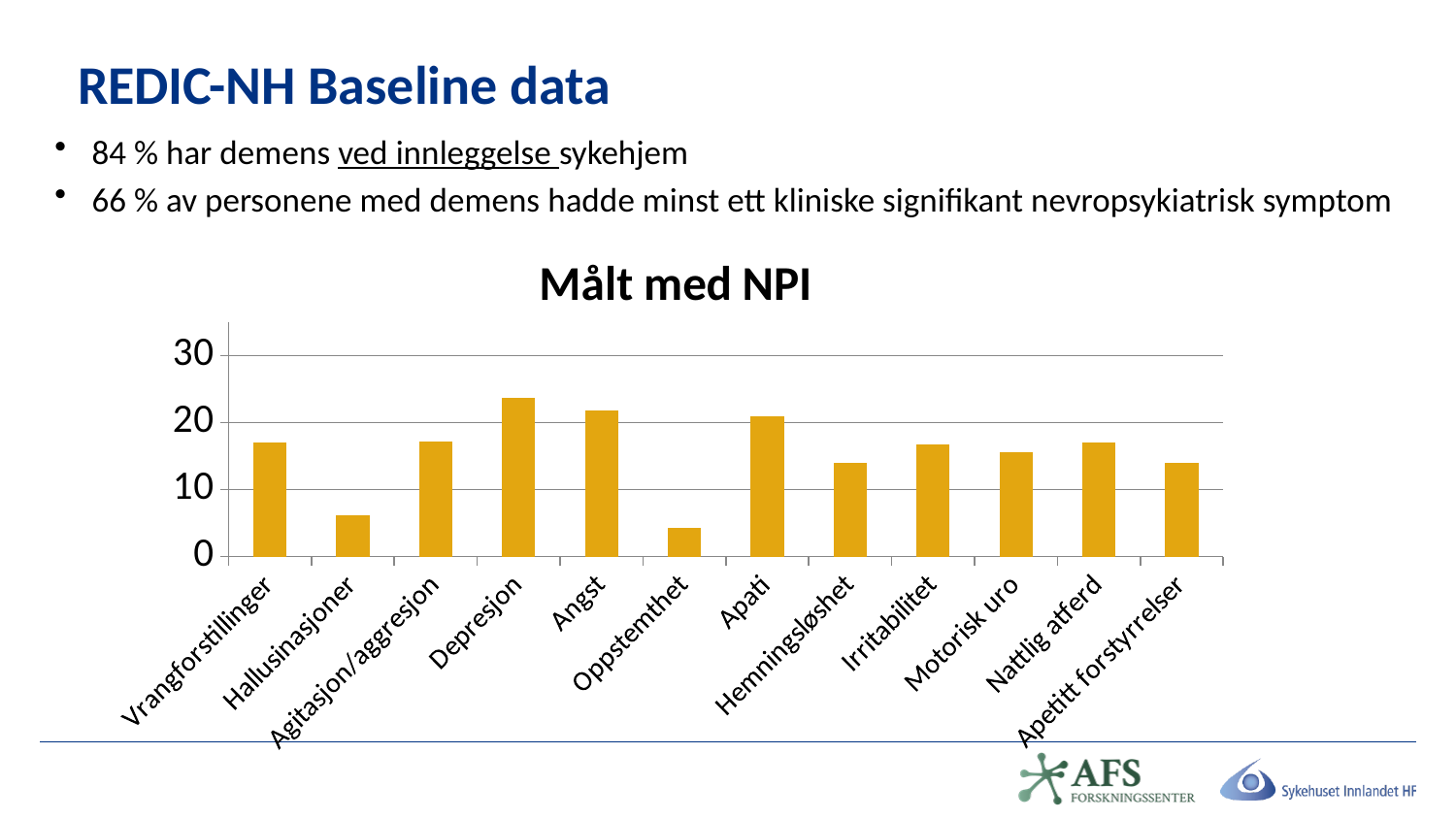
Which is larger, the value for Depresjon or the value for Hallusinasjoner? Depresjon What kind of chart is shown under the title "Målt med NPI"? bar chart Which category has the highest bar in the "Målt med NPI" chart? Depresjon Is the value for Hallusinasjoner greater or less than 10? less Is the value for Oppstemthet greater or less than 10? less Is the value for Depresjon greater or less than 20? greater How many categories are shown on the x axis of the "Målt med NPI" chart? 12 Which category has the lowest bar in the "Målt med NPI" chart? Oppstemthet What is the title of the chart on the slide? Målt med NPI Which is larger, the value for Angst or the value for Oppstemthet? Angst